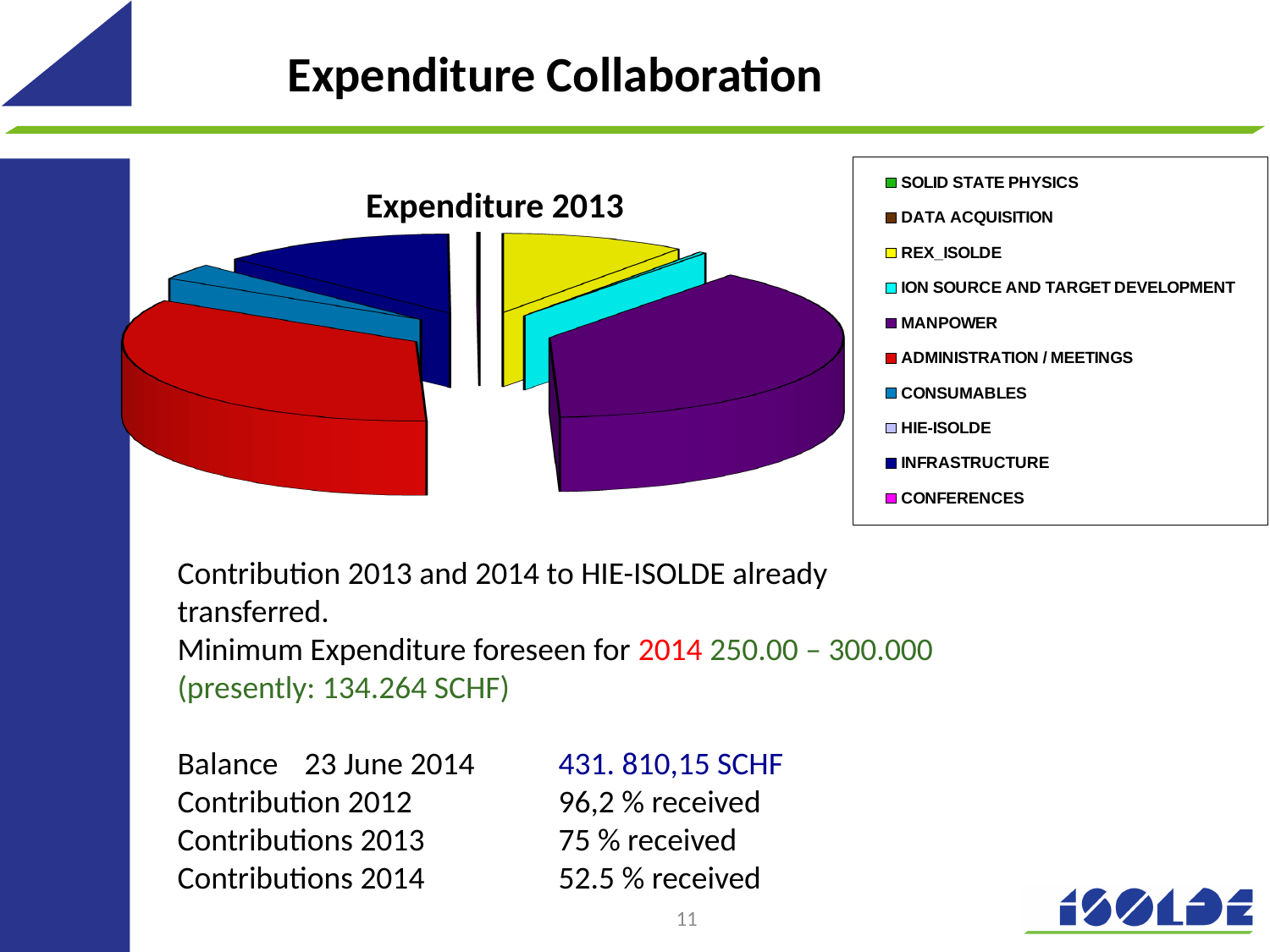
Which slice is larger, REX_ISOLDE or CONSUMABLES? REX_ISOLDE What is the title of the chart? Expenditure 2013 Which slice is larger, INFRASTRUCTURE or CONSUMABLES? INFRASTRUCTURE What kind of chart is shown on the slide? pie chart Which slice is larger, ADMINISTRATION / MEETINGS or REX_ISOLDE? ADMINISTRATION / MEETINGS What colour represents MANPOWER in the pie chart? purple How many categories does the chart's legend list? 10 Which category has the largest slice of the pie? MANPOWER